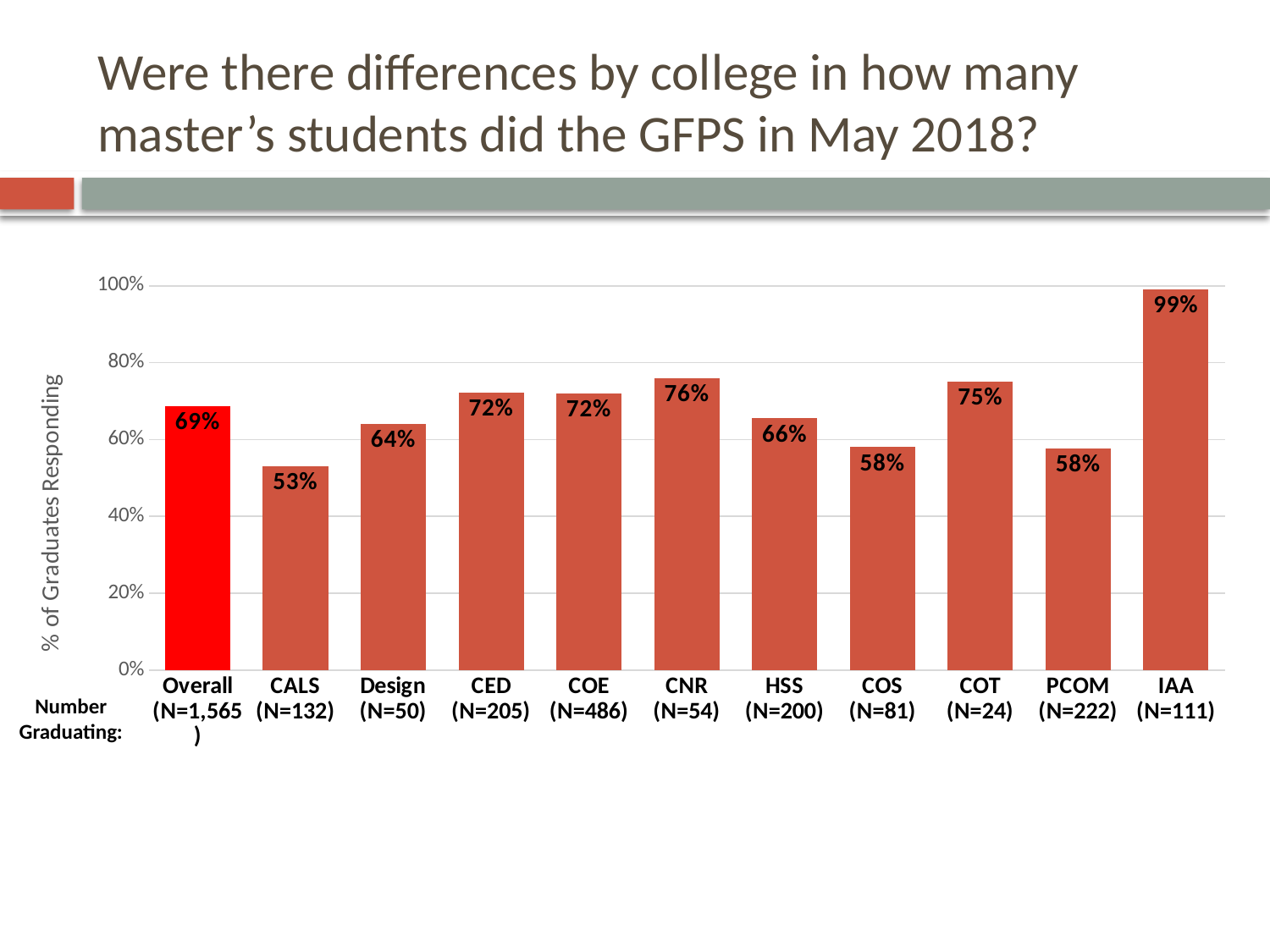
What is the label of the vertical axis? % of Graduates Responding How much higher is the COT percentage than the HSS percentage? 9% What is the number graduating shown for COE? N=486 What percentage of graduates responded for CNR? 76% Which college has the lowest percentage of graduates responding? CALS What type of chart is shown on the slide? Bar chart Which college has the highest percentage of graduates responding? IAA What is the difference between the IAA and CALS response percentages? 46% Which has a higher percentage of graduates responding, Design or CED? CED What percentage of graduates responded for PCOM? 58% What is the value shown for the Overall bar? 69% How many bars are shown in the chart? 11